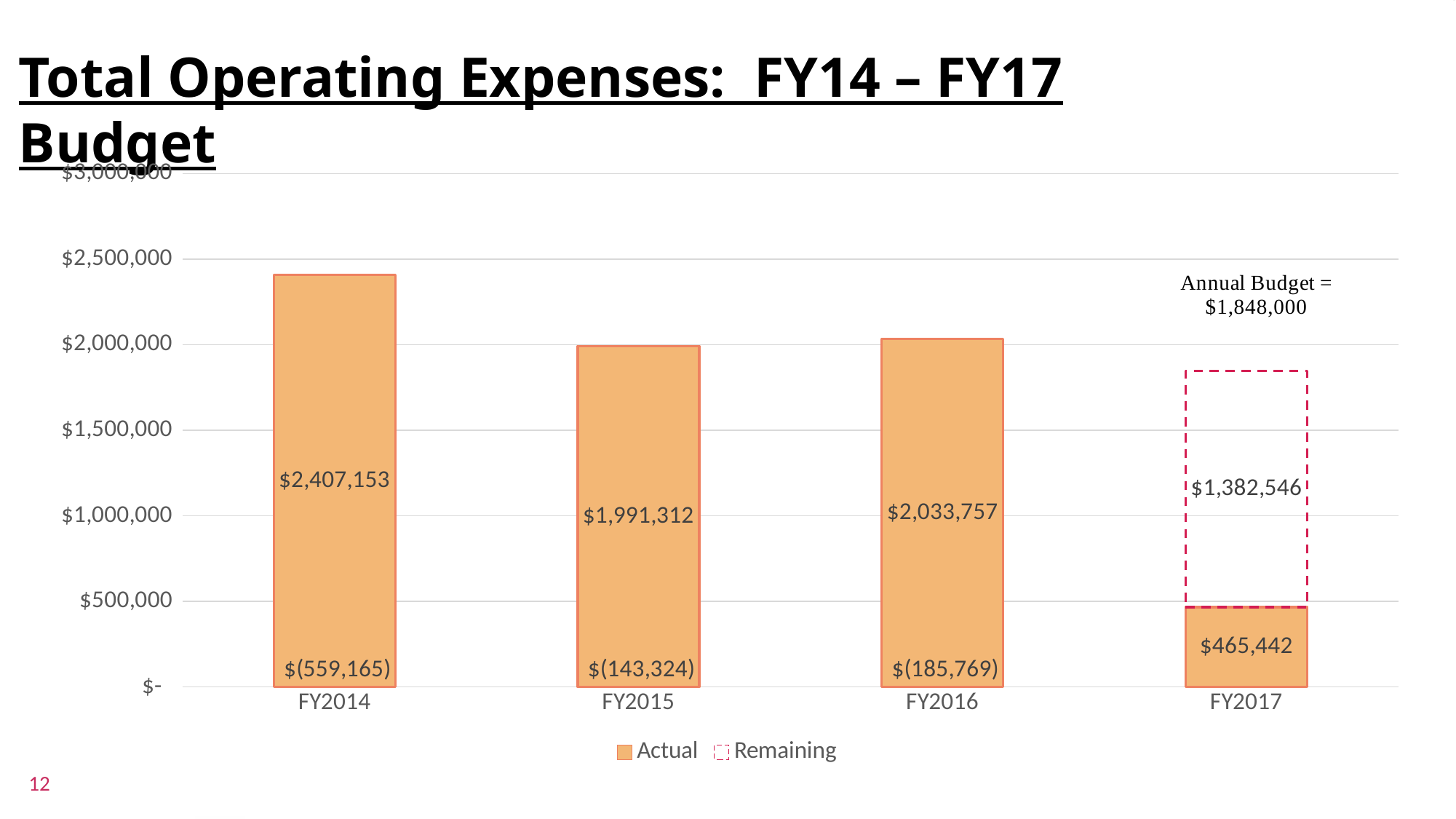
What is the Actual value for FY2017? $465,442 What is the Actual value for FY2014? $2,407,153 Which fiscal year has the lowest Actual value? FY2017 How many fiscal years are shown on the x axis? 4 How many series does the legend list? 2 Which is larger, the Actual value for FY2016 or for FY2015? FY2016 What is the difference between the Actual values for FY2014 and FY2015? $415,841 What is the Remaining value shown for FY2017? $1,382,546 Which fiscal year has the highest Actual value? FY2014 What is the Annual Budget stated on the chart? $1,848,000 What is the Remaining value shown for FY2015? $(143,324) Is the Actual value for FY2017 greater or less than $500,000? less